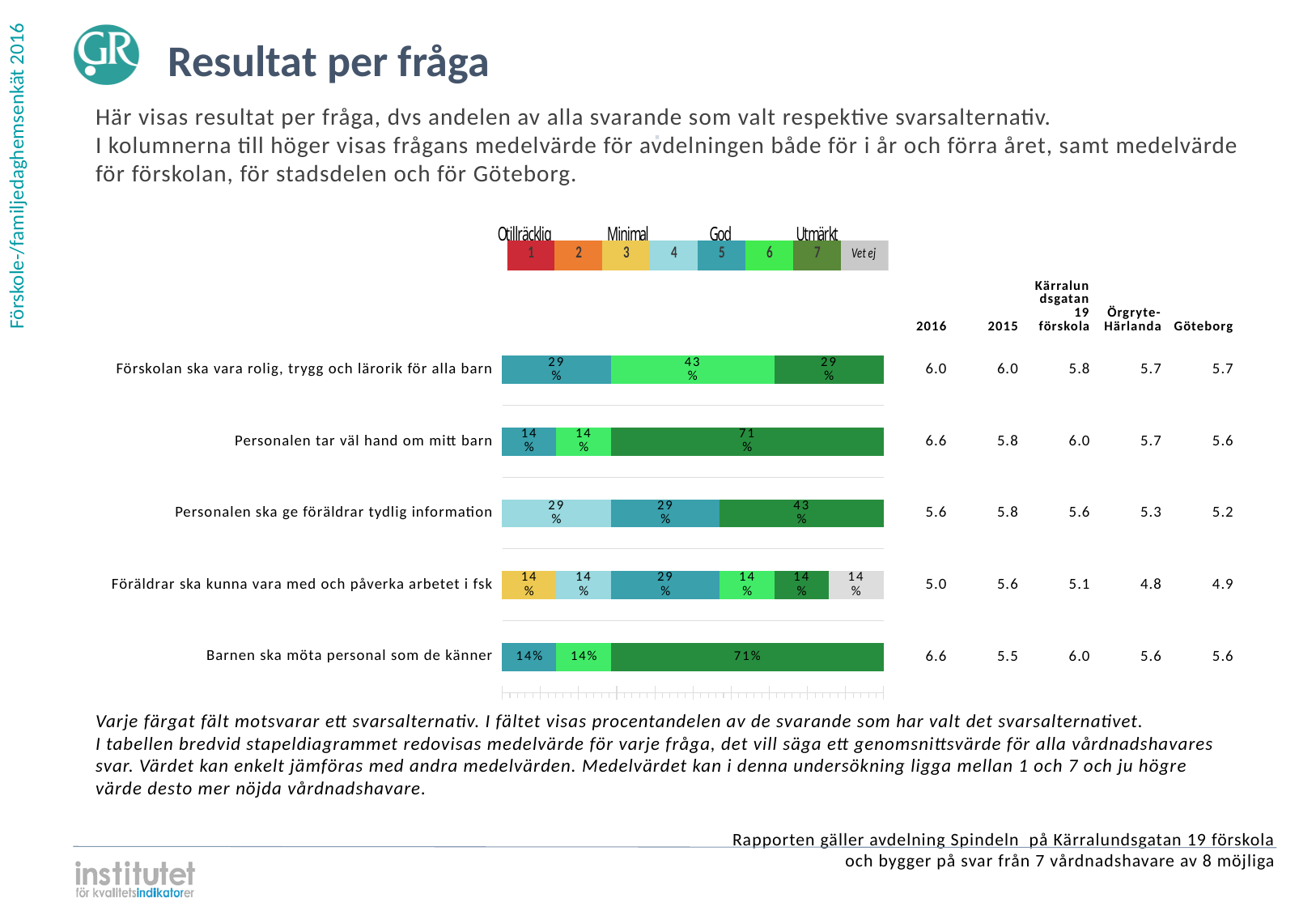
What kind of chart is used to show the results per question? Stacked bar chart What percentage of respondents chose option 7 (dark green) for 'Personalen tar väl hand om mitt barn'? 71% Which question has the smallest share of respondents choosing option 7 (dark green)? Föräldrar ska kunna vara med och påverka arbetet i fsk What percentage chose option 6 (light green) for 'Förskolan ska vara rolig, trygg och lärorik för alla barn'? 43% What percentage answered 'Vet ej' for 'Föräldrar ska kunna vara med och påverka arbetet i fsk'? 14% For 'Personalen ska ge föräldrar tydlig information', how many percentage points larger is the option 7 share than the option 4 share? 14 percentage points What label does the legend give to response option 1? Otillräcklig How many coloured segments does the bar for 'Föräldrar ska kunna vara med och påverka arbetet i fsk' contain? 6 How many response options does the legend above the chart list? 8 What percentage chose option 4 (light blue) for 'Personalen ska ge föräldrar tydlig information'? 29% How many questions (categories) are shown as bars in the chart? 5 For 'Förskolan ska vara rolig, trygg och lärorik för alla barn', which has the larger share: option 5 or option 6? Option 6